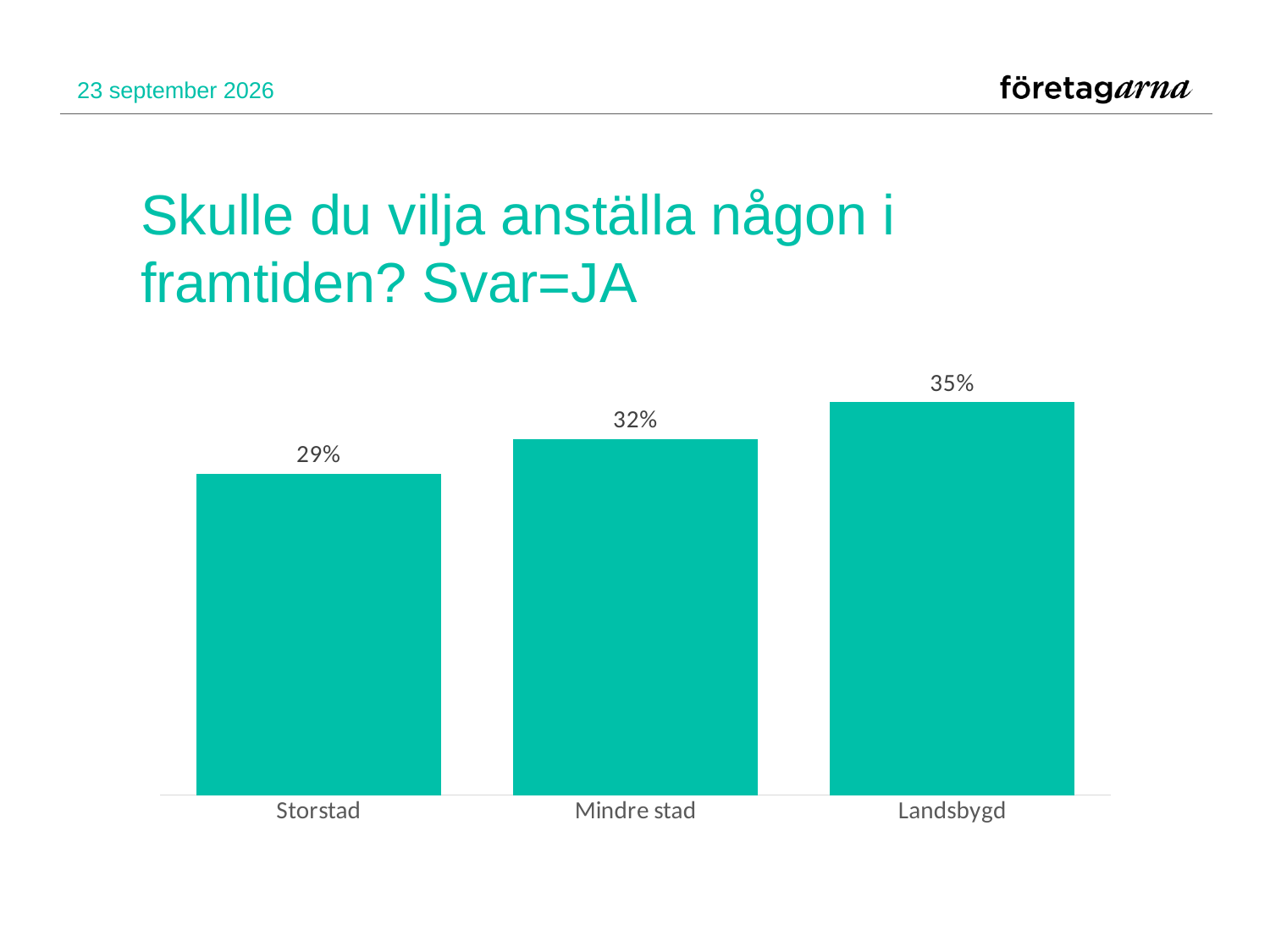
Do the values rise or fall from left to right across the categories? Rise Which category has the lowest value? Storstad Which is larger, the value for Mindre stad or the value for Landsbygd? Landsbygd What kind of chart is shown on the slide? Bar chart What is the difference between the values for Landsbygd and Storstad? 6 percentage points What is the value for Mindre stad? 32% What is the difference between the values for Mindre stad and Storstad? 3 percentage points What is the value for Storstad? 29% What is the title of the slide above the chart? Skulle du vilja anställa någon i framtiden? Svar=JA How many categories are shown in the chart? 3 What is the value for Landsbygd? 35% Which category has the highest value? Landsbygd